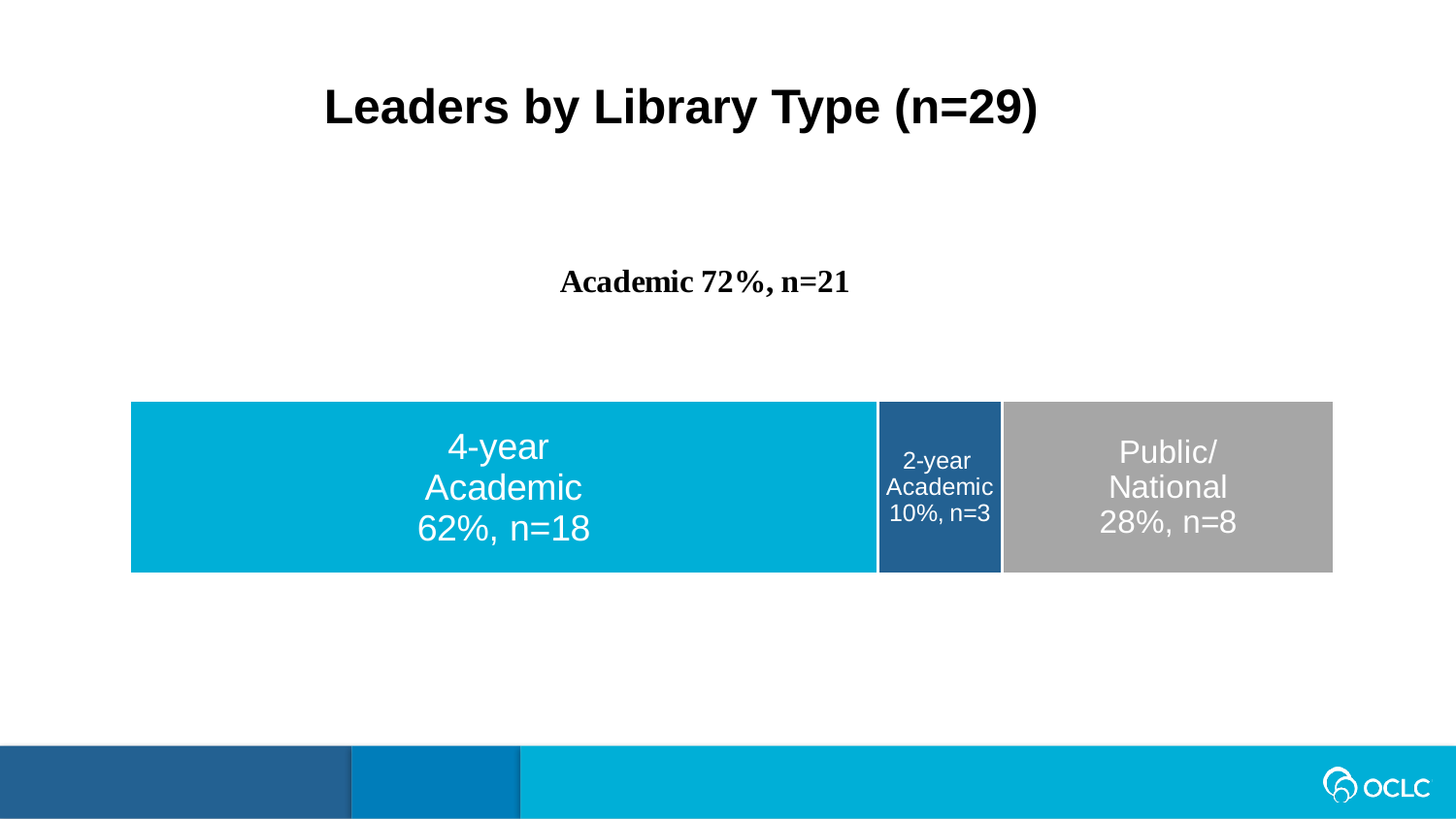
What percentage and count does the annotation above the bar give for Academic libraries overall? 72%, n=21 What percentage of leaders are from 2-year Academic libraries? 10% What is the difference in percentage points between the 4-year Academic and Public/National segments? 34 Which library type has the smallest share of leaders? 2-year Academic What is the combined number of leaders (n) across the 4-year Academic and 2-year Academic segments? 21 How many leaders (n) are from Public/National libraries? 8 Which segment is larger: Public/National or 2-year Academic? Public/National What percentage of leaders are from 4-year Academic libraries? 62% Which library type has the largest share of leaders? 4-year Academic What is the title of the chart? Leaders by Library Type (n=29) How many library type segments are shown in the bar? 3 What kind of chart is shown on the slide? Stacked bar chart